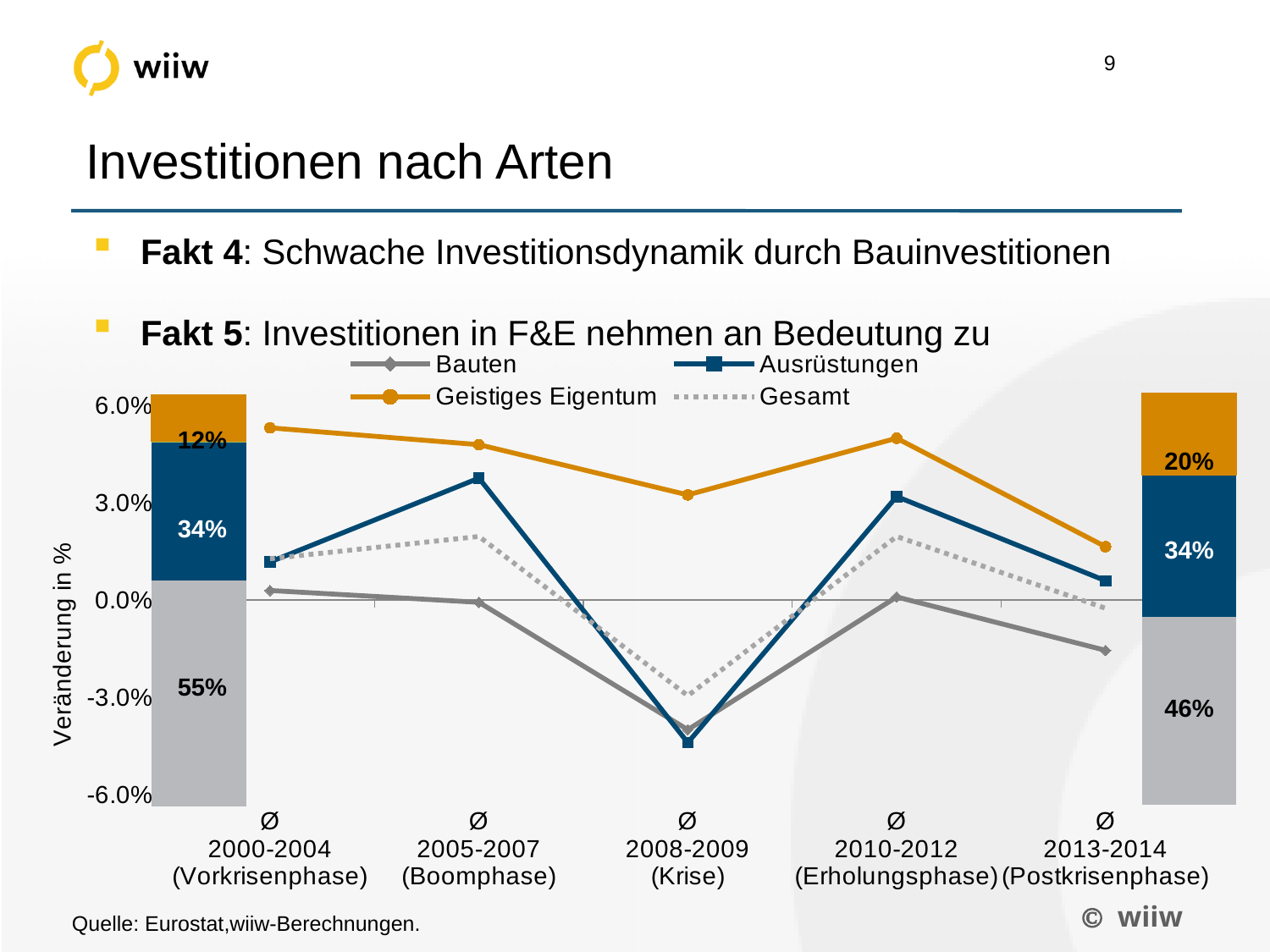
What share is printed on the grey (Bauten) segment of the stacked bar on the left side of the chart? 55% Which series has the highest value in the 2008-2009 (Krise) period? Geistiges Eigentum How many series does the legend of the chart list? 4 In which period does the Ausrüstungen series reach its lowest value? 2008-2009 (Krise) Is the value for Geistiges Eigentum in 2013-2014 (Postkrisenphase) greater or less than 3.0%? less Is the value for Ausrüstungen in 2005-2007 (Boomphase) greater or less than 3.0%? greater In the stacked bar on the right side of the chart, how much larger is the grey segment (46%) than the orange segment (20%)? 26 percentage points In 2010-2012 (Erholungsphase), which is larger: the value for Ausrüstungen or the value for Bauten? Ausrüstungen Is the value for Gesamt in 2008-2009 (Krise) greater or less than 0.0%? less How many periods are shown along the x axis of the chart? 5 What share is printed on the orange (Geistiges Eigentum) segment of the stacked bar on the right side of the chart? 20% What kind of chart is used to show the series Bauten, Ausrüstungen, Geistiges Eigentum and Gesamt? line chart